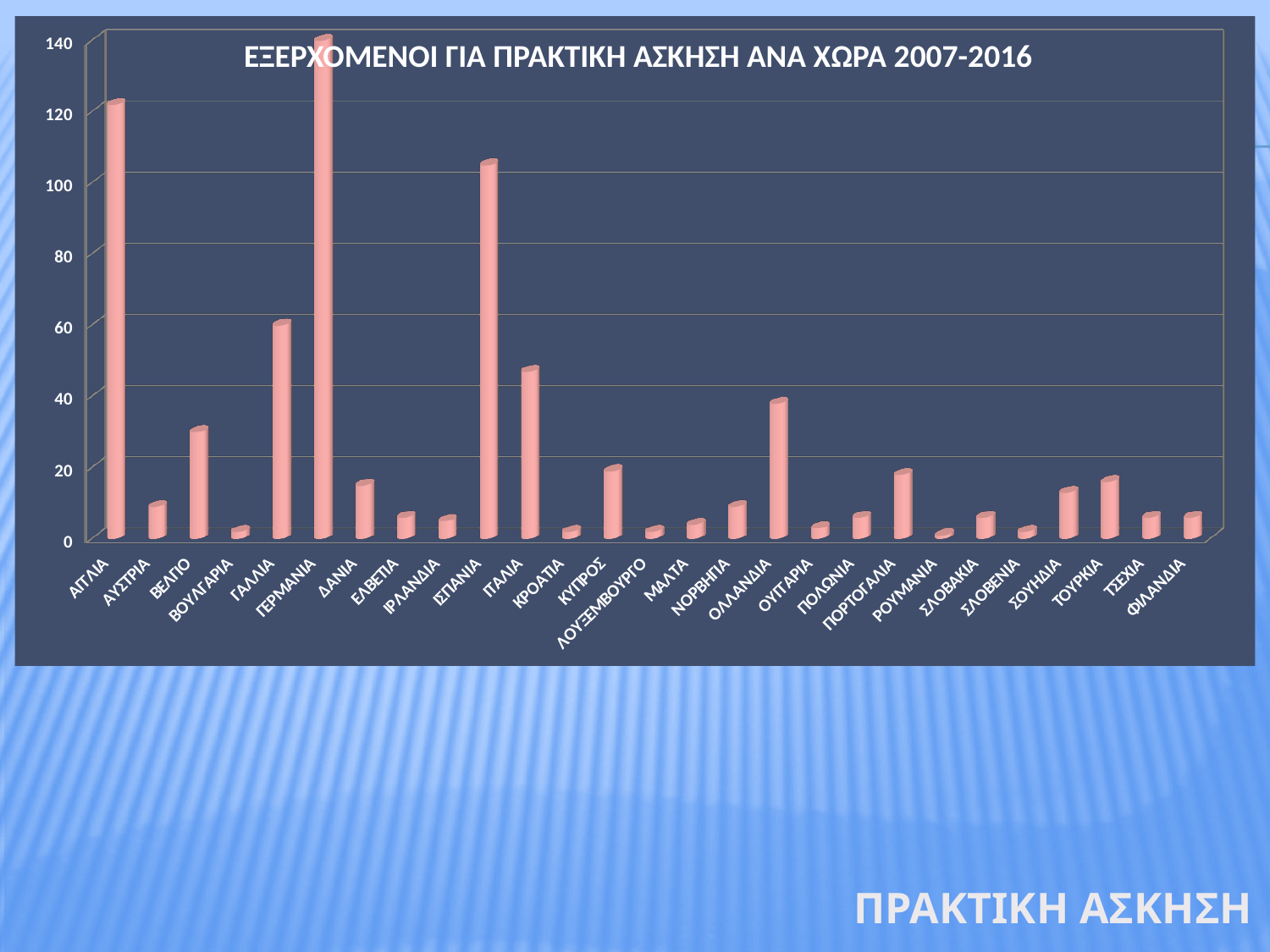
Which has a higher value, ΑΓΓΛΙΑ or ΙΣΠΑΝΙΑ? ΑΓΓΛΙΑ Is the value for ΚΥΠΡΟΣ greater or less than 40? less Is the value for ΔΑΝΙΑ greater or less than 20? less What type of chart is shown on the slide? Bar chart Is the value for ΑΓΓΛΙΑ greater or less than 100? greater Which has a higher value, ΓΑΛΛΙΑ or ΙΤΑΛΙΑ? ΓΑΛΛΙΑ Which country has the highest bar in the chart? ΓΕΡΜΑΝΙΑ What is the title of the chart? ΕΞΕΡΧΟΜΕΝΟΙ ΓΙΑ ΠΡΑΚΤΙΚΗ ΑΣΚΗΣΗ ΑΝΑ ΧΩΡΑ 2007-2016 Which has a higher value, ΒΕΛΓΙΟ or ΟΛΛΑΝΔΙΑ? ΟΛΛΑΝΔΙΑ How many countries are shown on the x axis of the chart? 27